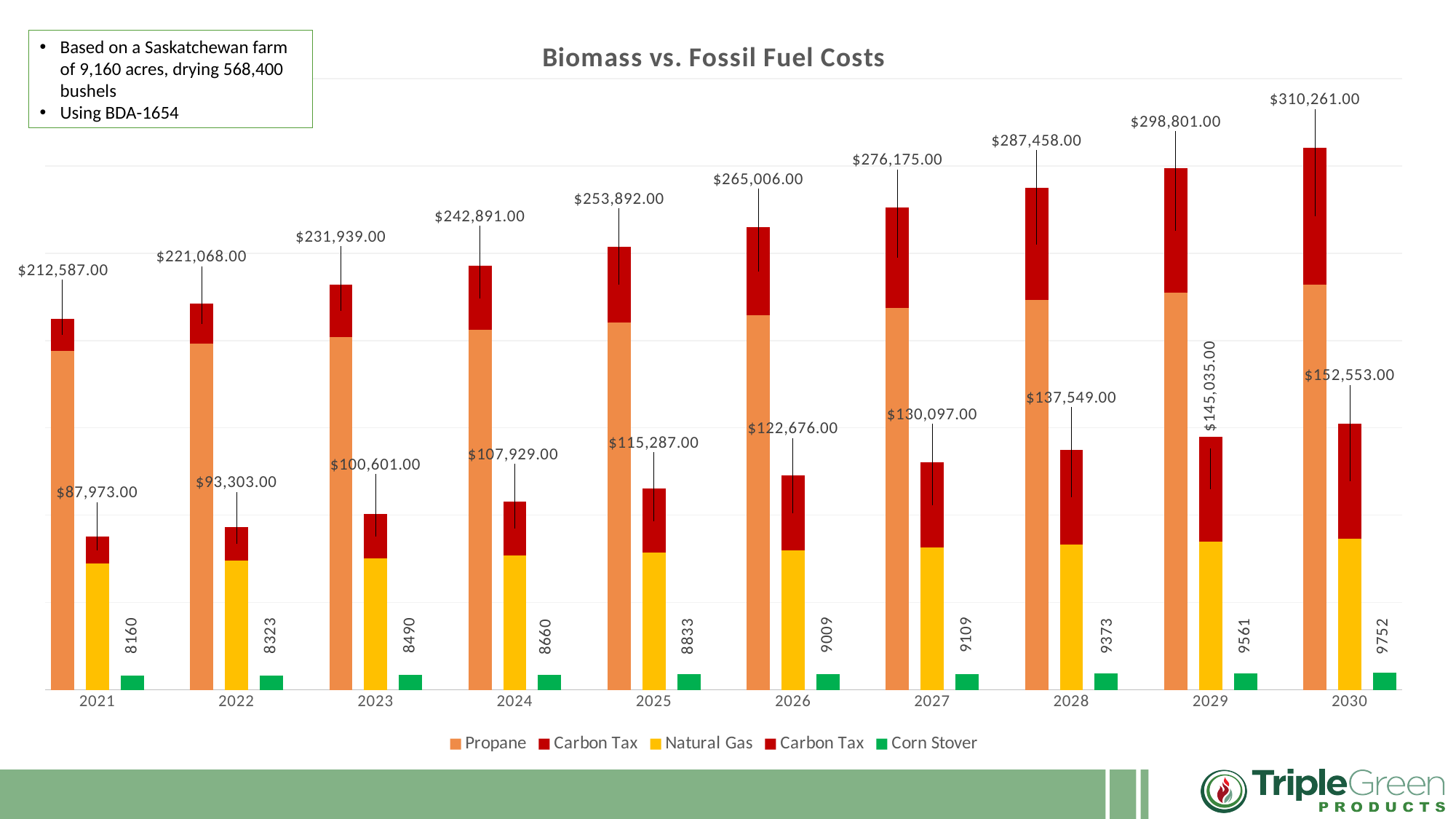
In which year is the Corn Stover value the lowest? 2021 Do the Corn Stover values rise or fall from 2021 to 2030? rise What is the difference between the propane total in 2030 ($310,261.00) and in 2021 ($212,587.00)? $97,674.00 What is the labelled total for the propane bar in 2021? $212,587.00 How many years are shown on the x axis? 10 In which year is the propane total the highest? 2030 What is the chart's title? Biomass vs. Fossil Fuel Costs How many series does the legend list? 5 What is the labelled total for the natural gas bar in 2030? $152,553.00 What is the value labelled for Corn Stover in 2026? 9009 What type of chart is shown on the slide? bar chart Which is larger in 2025: the propane total or the natural gas total? the propane total